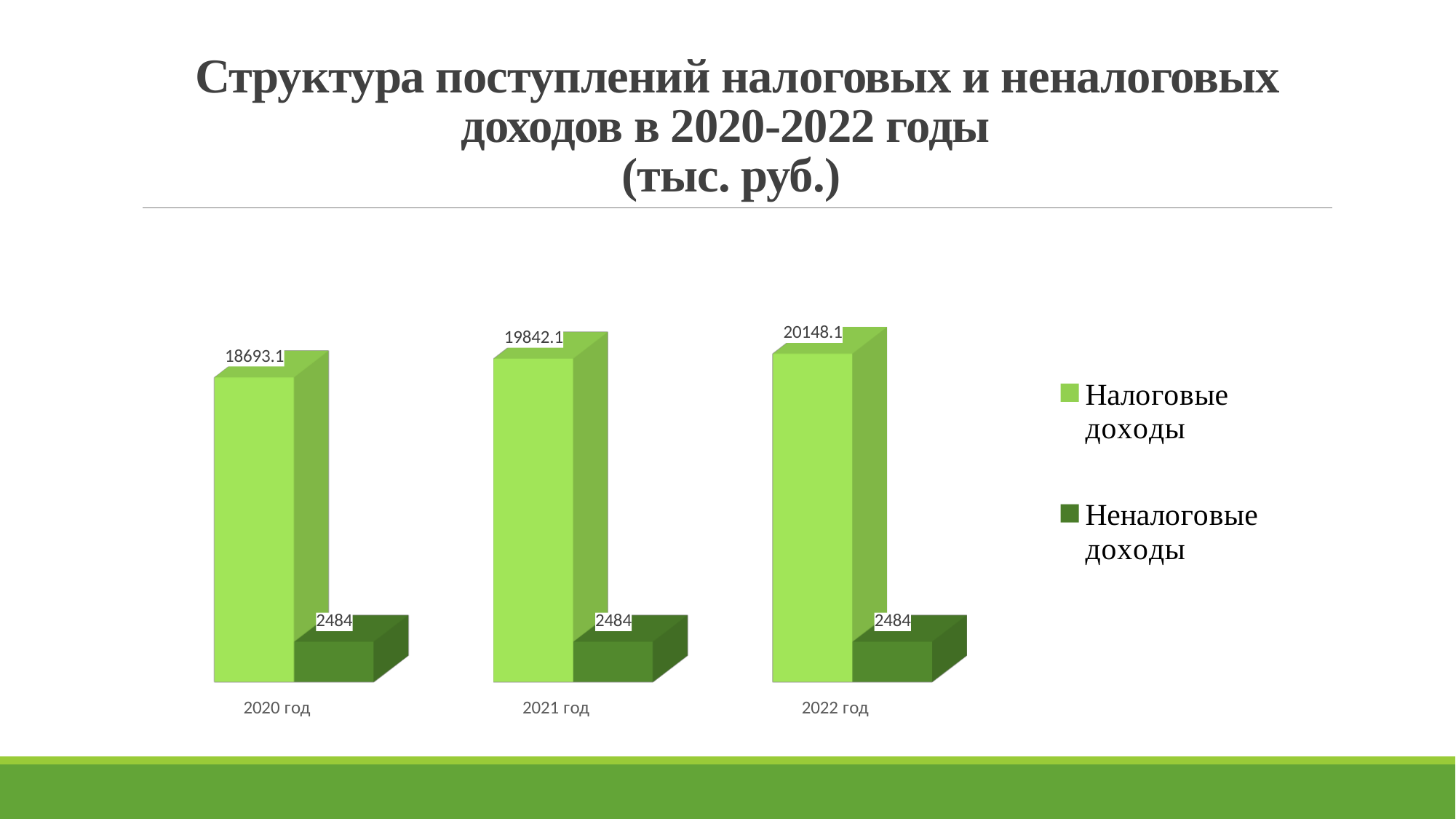
How many series does the legend list? 2 In which year is Налоговые доходы lowest? 2020 год What is the difference between Налоговые доходы in 2021 год and 2020 год? 1149 In which year is Налоговые доходы highest? 2022 год Do the values of Налоговые доходы rise or fall from 2020 год to 2022 год? rise Which is larger in 2020 год: Налоговые доходы or Неналоговые доходы? Налоговые доходы What is the difference between Налоговые доходы and Неналоговые доходы in 2022 год? 17664.1 What is the value of Налоговые доходы for 2021 год? 19842.1 What is the value of Налоговые доходы for 2022 год? 20148.1 How many years are shown on the x axis? 3 What is the value of Налоговые доходы for 2020 год? 18693.1 What is the value of Неналоговые доходы for 2022 год? 2484